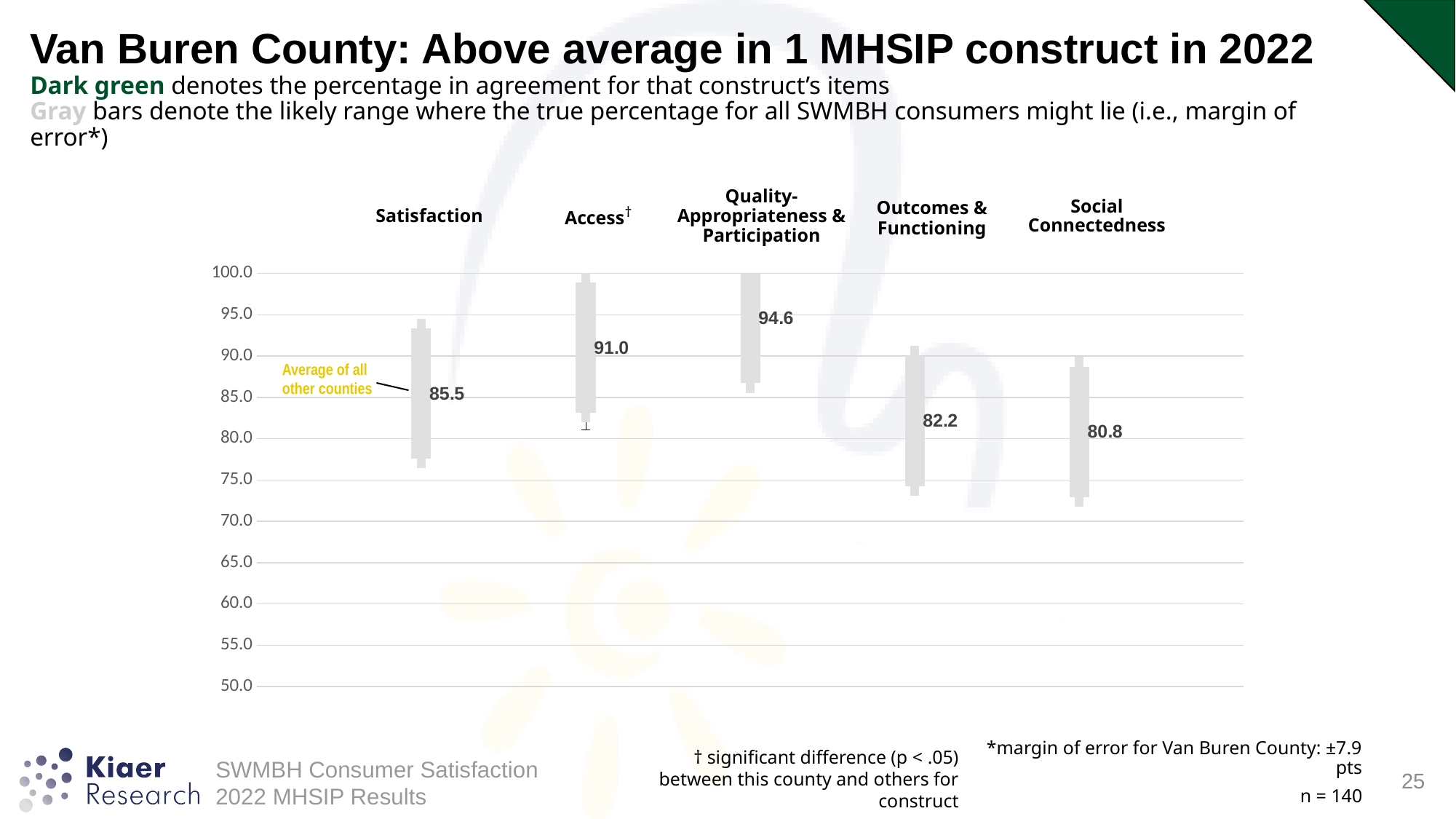
What value is labelled for the Social Connectedness construct? 80.8 Which construct is marked with a dagger (†) indicating a significant difference? Access Which construct has the lowest labelled value? Social Connectedness Is the labelled value for Access greater or less than 90.0? greater What value is labelled for the Satisfaction construct? 85.5 What value is labelled for the Quality-Appropriateness & Participation construct? 94.6 What is the difference between the labelled values for Access and Satisfaction? 5.5 Which has the larger labelled value, Outcomes & Functioning or Access? Access Which construct has the highest labelled value? Quality-Appropriateness & Participation What value is labelled for the Outcomes & Functioning construct? 82.2 How many constructs are shown on the chart? 5 What is the lowest value shown on the vertical axis? 50.0